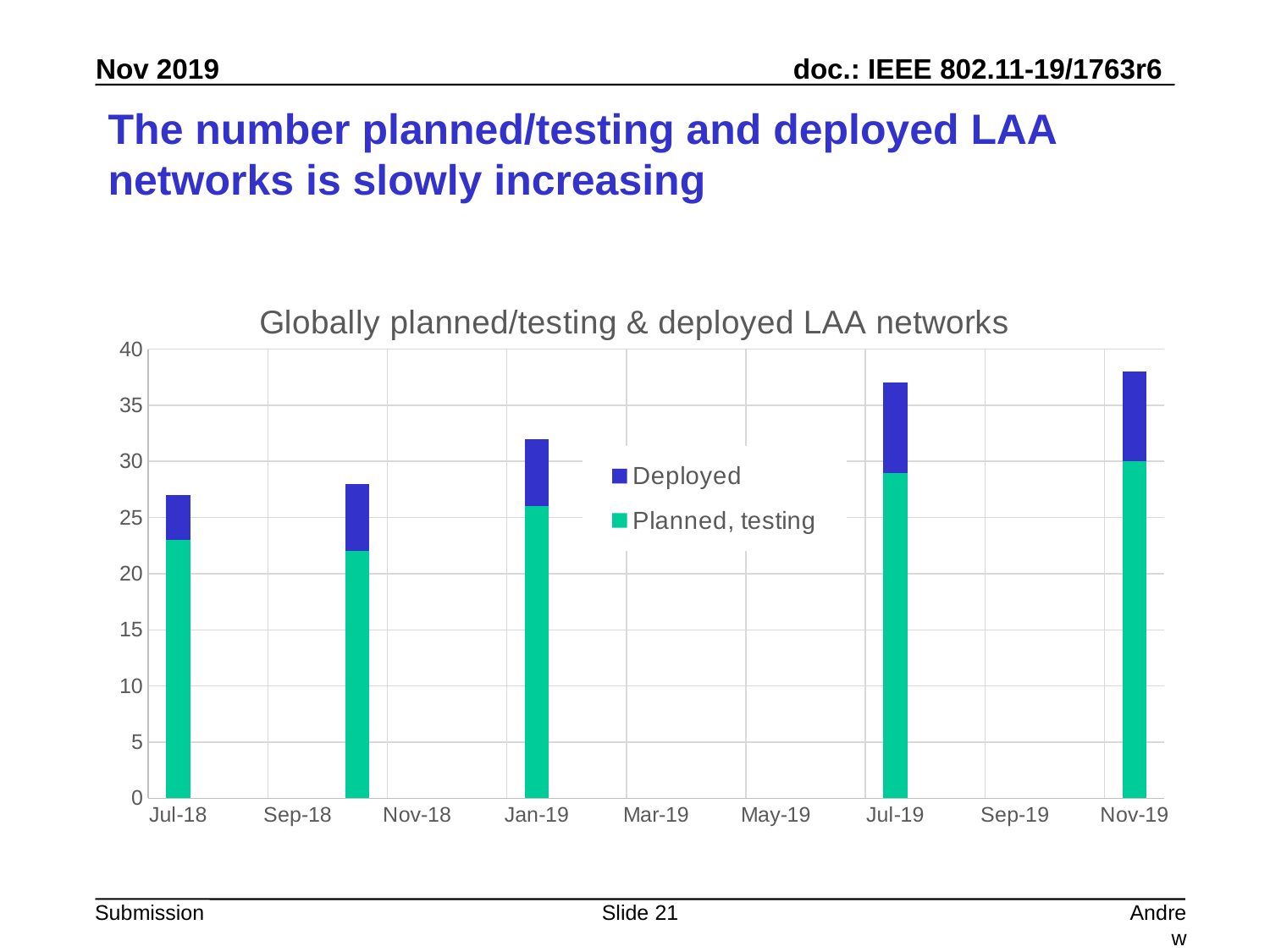
What type of chart is shown on the slide? Stacked bar chart Is the total value for Jan-19 greater or less than 30? greater What is the title of the chart? Globally planned/testing & deployed LAA networks How many series does the legend list? 2 Which series is shown in green? Planned, testing Is the total value for Jul-18 greater or less than 25? greater Which has the larger 'Planned, testing' value, Jan-19 or Nov-19? Nov-19 Which has the larger total, Jan-19 or Jul-19? Jul-19 Do the total bar heights rise or fall from Jul-18 to Nov-19? Rise Is the total value for Jul-19 greater or less than 35? greater How many bars are plotted in the chart? 5